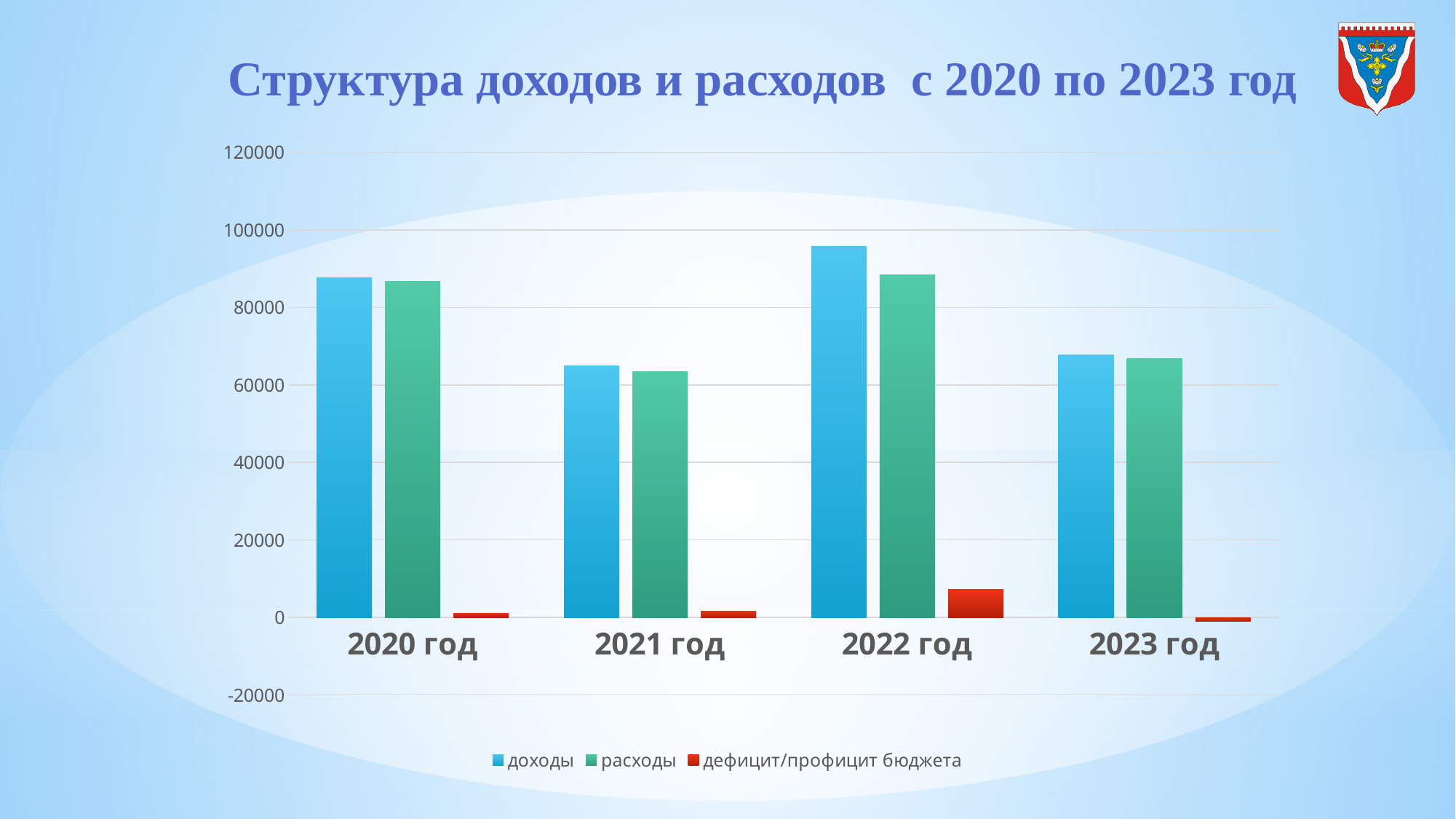
Is the value for доходы in 2022 год greater or less than 80000? greater Which is larger, расходы in 2021 год or расходы in 2020 год? 2020 год In which year is the value for дефицит/профицит бюджета the highest? 2022 год What kind of chart is shown on the slide? bar chart How many series does the legend list? 3 In which year is the value for доходы the highest? 2022 год What is the title of the chart on the slide? Структура доходов и расходов с 2020 по 2023 год Which is larger, доходы in 2020 год or доходы in 2022 год? 2022 год How many year categories are shown on the x axis? 4 Is the value for дефицит/профицит бюджета in 2022 год greater or less than 20000? less Is the value for расходы in 2021 год greater or less than 80000? less Does the value for доходы rise or fall from 2021 год to 2022 год? rise